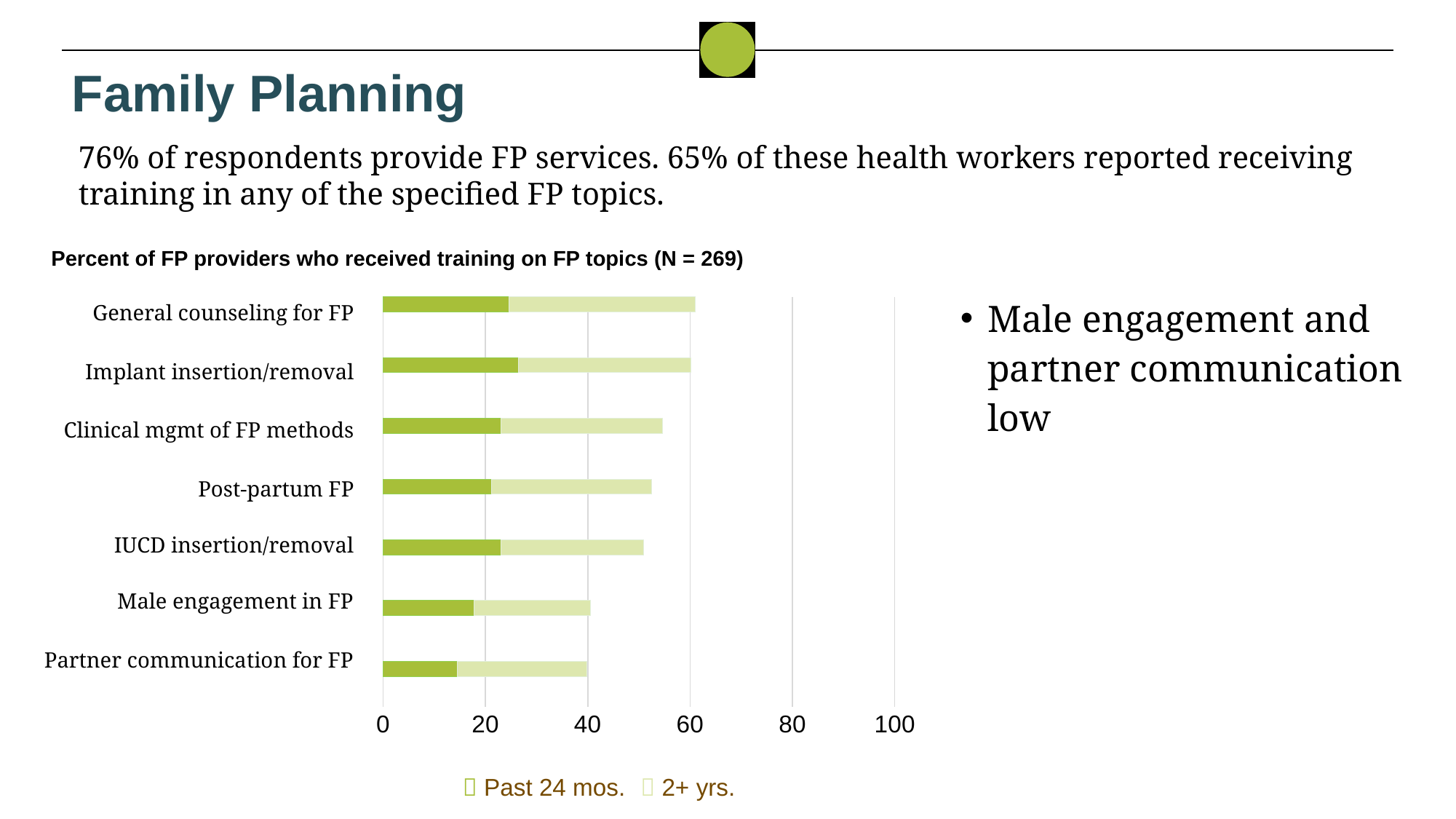
Which has a longer total bar: Partner communication for FP or Clinical mgmt of FP methods? Clinical mgmt of FP methods What is the sample size (N) given in the chart title? 269 Is the total bar length for General counseling for FP greater or less than 40? greater What are the two series named in the chart legend? Past 24 mos. and 2+ yrs. Is the Past 24 mos. value for Partner communication for FP greater or less than 20? less What kind of chart is shown on the slide? bar chart Is the total bar length for Male engagement in FP greater or less than 60? less How many FP topics (categories) are plotted in the chart? 7 Which has a longer total bar: General counseling for FP or Male engagement in FP? General counseling for FP How many series does the chart legend list? 2